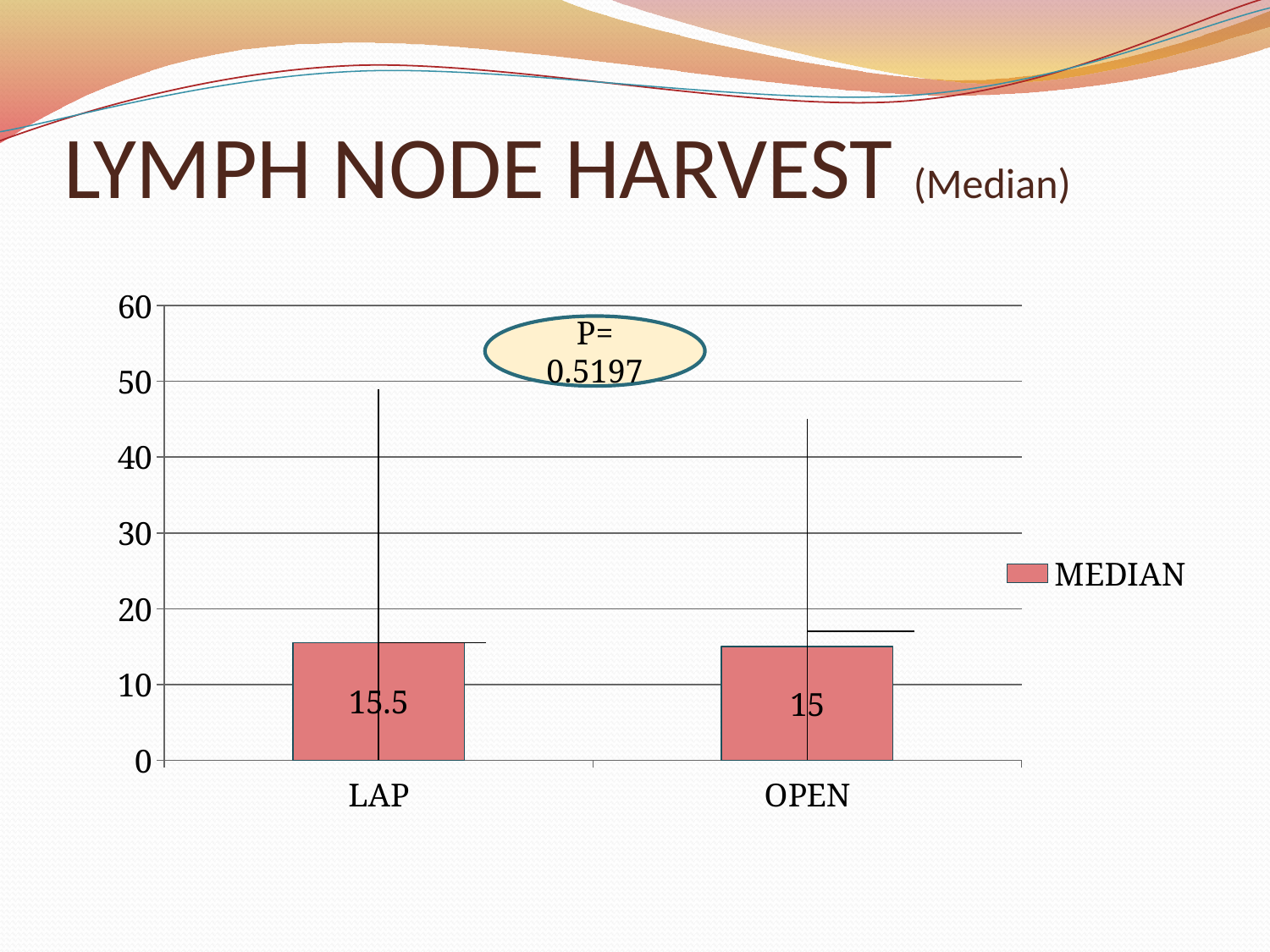
What kind of chart is shown on the slide? bar chart What is the difference between the median values for LAP and OPEN? 0.5 What is the median lymph node harvest value for OPEN? 15 How many series does the legend list? 1 Is the median value for OPEN greater or less than 10? greater What is the P value shown on the chart? 0.5197 Which category has the higher median value, LAP or OPEN? LAP What is the name of the series listed in the legend? MEDIAN What is the median lymph node harvest value for LAP? 15.5 Is the median value for LAP greater or less than 20? less Which category has the lowest median value? OPEN How many categories are shown on the x axis? 2